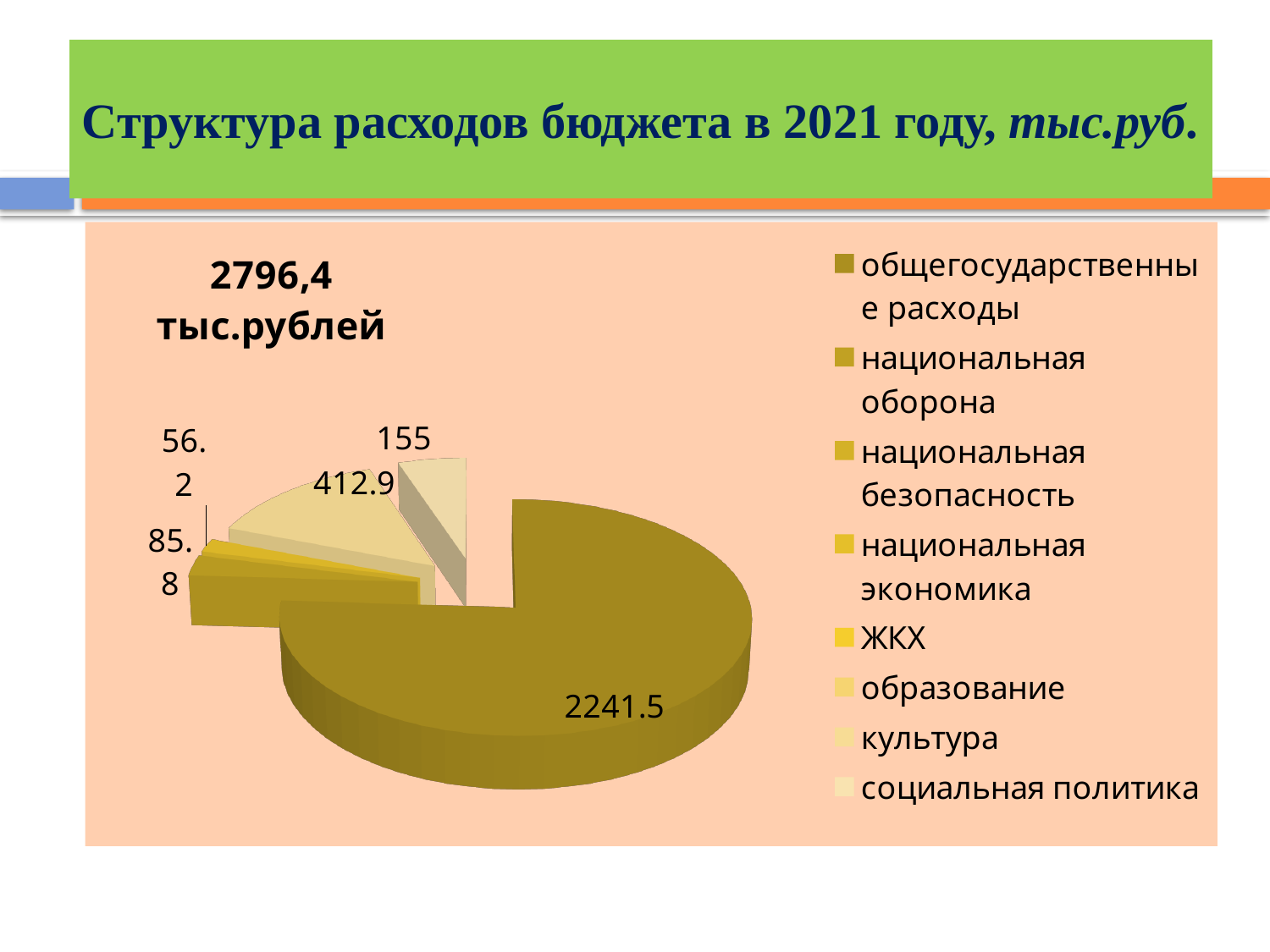
How many entries does the chart's legend list? 8 What is the difference between the slice labelled 412.9 and the slice labelled 155? 257.9 What kind of chart is shown on the slide? pie chart What is the smallest value labelled on the pie chart? 56.2 Which is larger, the slice labelled 412.9 or the slice labelled 155? 412.9 Which legend category corresponds to the largest (darkest) slice of the pie? общегосударственные расходы What is the difference between the slices labelled 85.8 and 56.2? 29.6 How many data labels are printed on the pie chart? 5 What is the value of the largest slice of the pie? 2241.5 What total amount is printed in the text above the pie chart? 2796,4 тыс.рублей What is the difference between the largest slice (2241.5) and the slice labelled 412.9? 1828.6 What is the title of the slide's chart? 2796,4 тыс.рублей